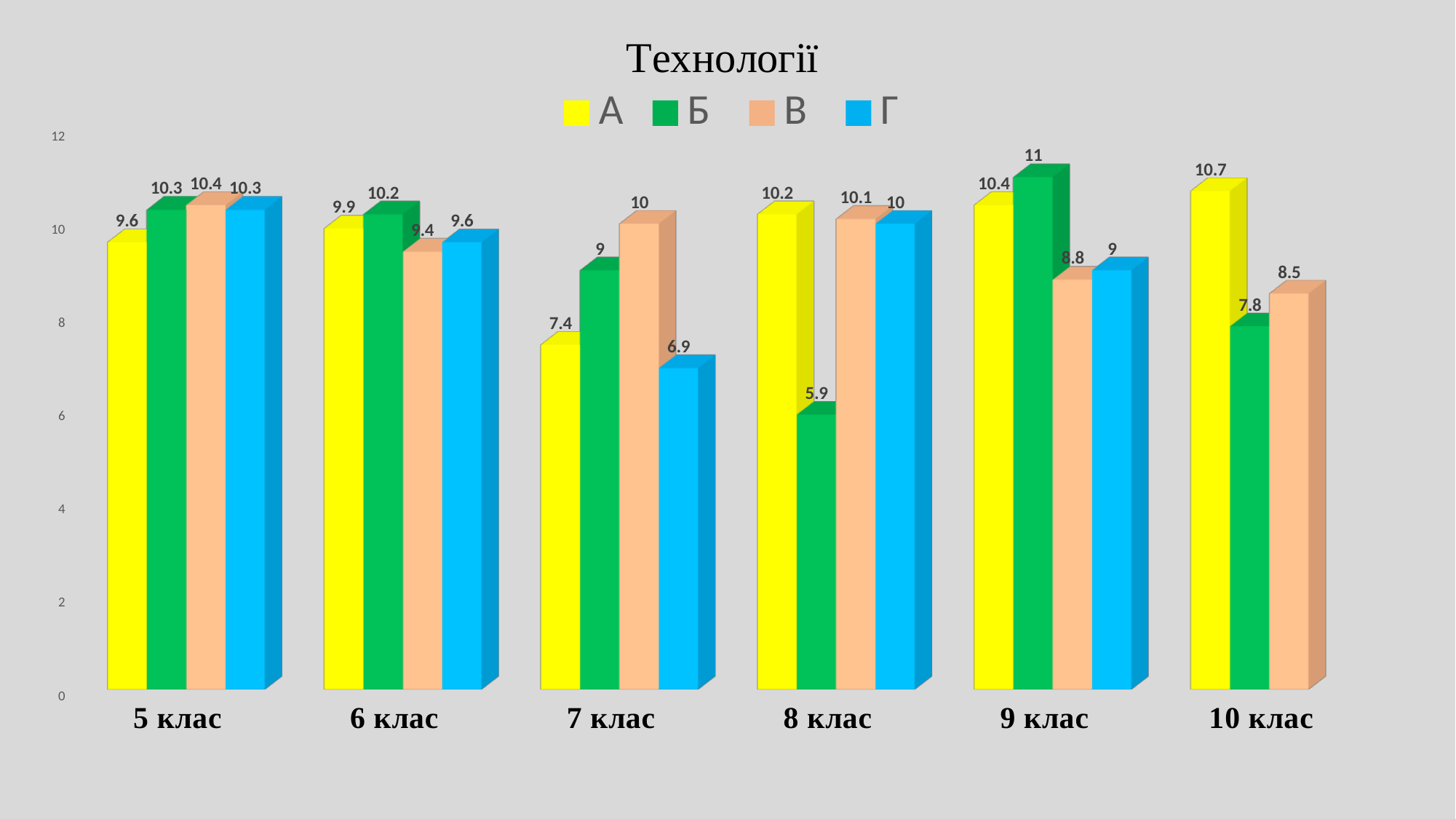
What is the title of the chart? Технології Which is larger in 6 клас: the value for series В or series Г? Г Which category has the lowest value for series Г? 7 клас What is the value for series А in 10 клас? 10.7 What is the difference between the values for series А and series Б in 10 клас? 2.9 Which category has no bar for series Г? 10 клас How many series does the legend list? 4 What is the value for series В in 7 клас? 10 Which category has the highest value for series Б? 9 клас What kind of chart is shown on the slide? bar chart How many categories are shown on the x axis? 6 What is the value for series Б in 8 клас? 5.9